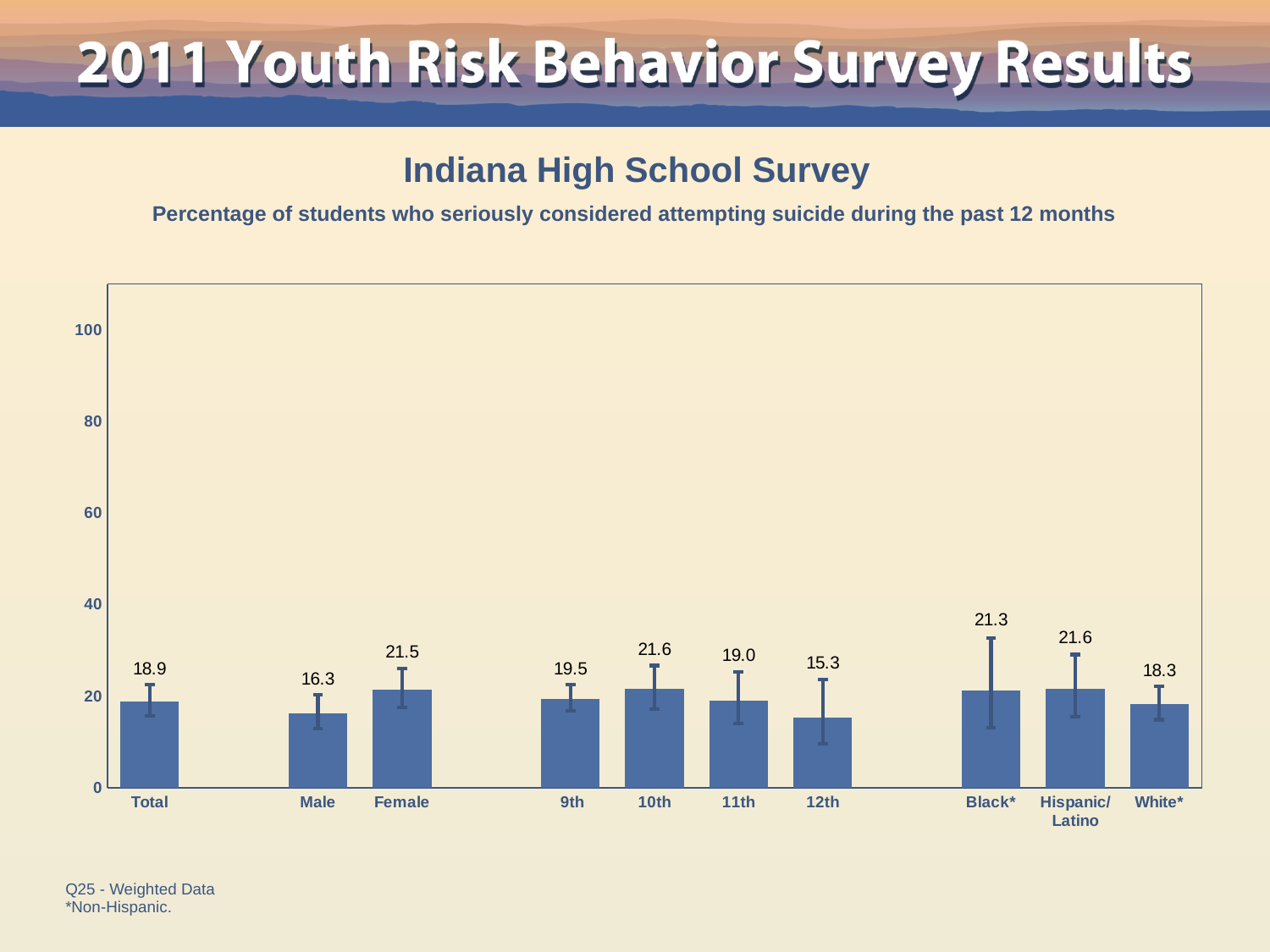
Is the value for 11th grade greater or less than 40? less What is the difference between the 10th grade and 12th grade values? 6.3 What is the value shown for 12th grade students? 15.3 Which is larger, the value for Male or the value for Female? Female What is the value shown for Black* students? 21.3 What percentage of students in the Total category seriously considered attempting suicide during the past 12 months? 18.9 Which category has the lowest value on the chart? 12th Which is larger, the value for White* or the value for Hispanic/Latino? Hispanic/Latino What kind of chart is shown on the slide? bar chart What is the difference between the Female and Male values? 5.2 What is the value shown for Female students? 21.5 How many categories are shown on the x axis of the chart? 10